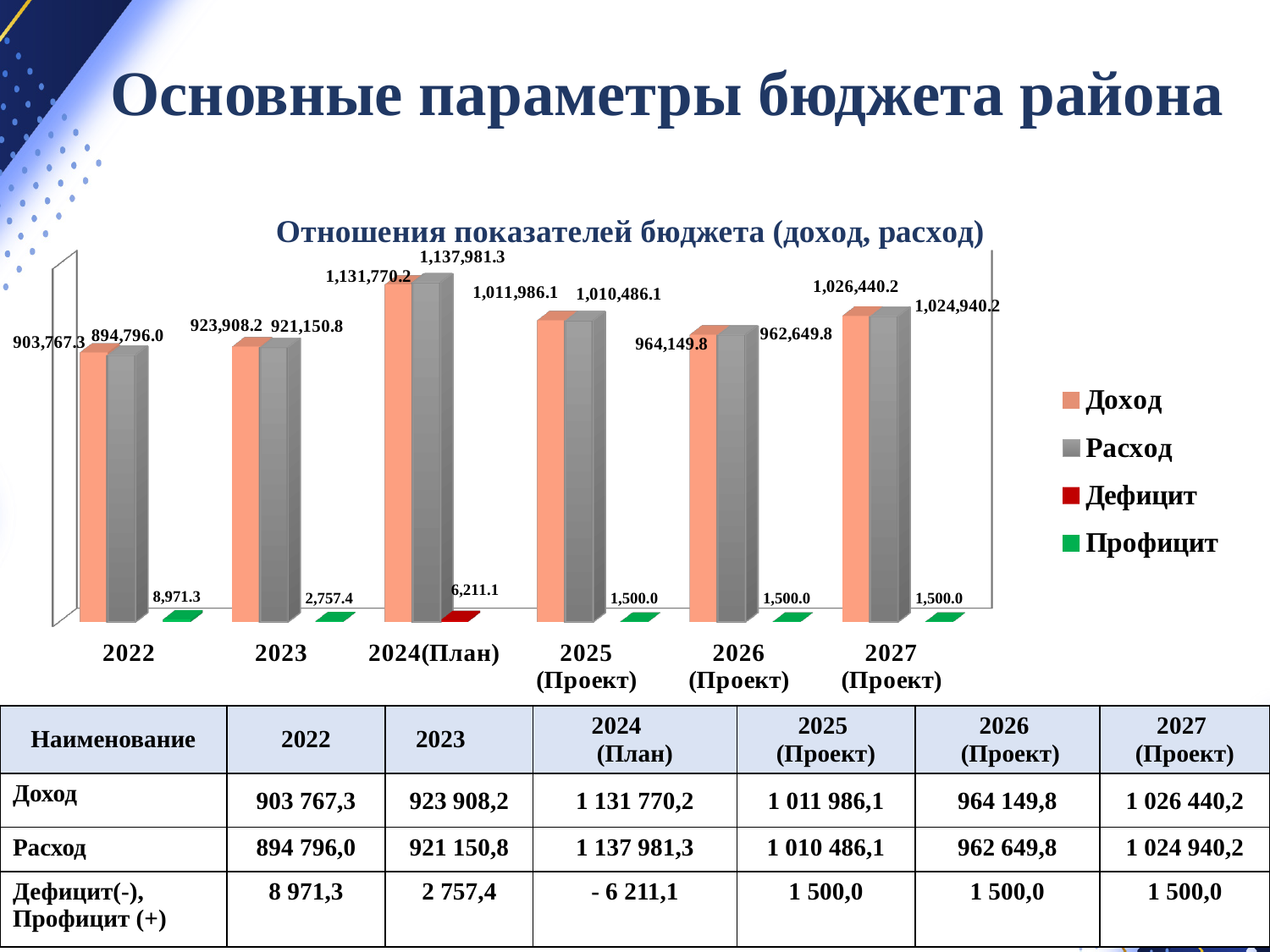
What is the title of the chart? Отношения показателей бюджета (доход, расход) What is the value of Профицит for 2023? 2,757.4 In which year is Расход the lowest? 2022 What kind of chart is shown on the slide? bar chart How many series does the chart legend list? 4 What is the value of Расход for 2026 (Проект)? 962,649.8 In which year is Доход the highest? 2024(План) Does Доход rise or fall from 2022 to 2024(План)? rise In 2024(План), which is larger: Доход or Расход? Расход What is the value of Доход for 2022? 903,767.3 What is the difference between Доход and Расход in 2022? 8,971.3 How many year categories are shown on the x axis of the chart? 6